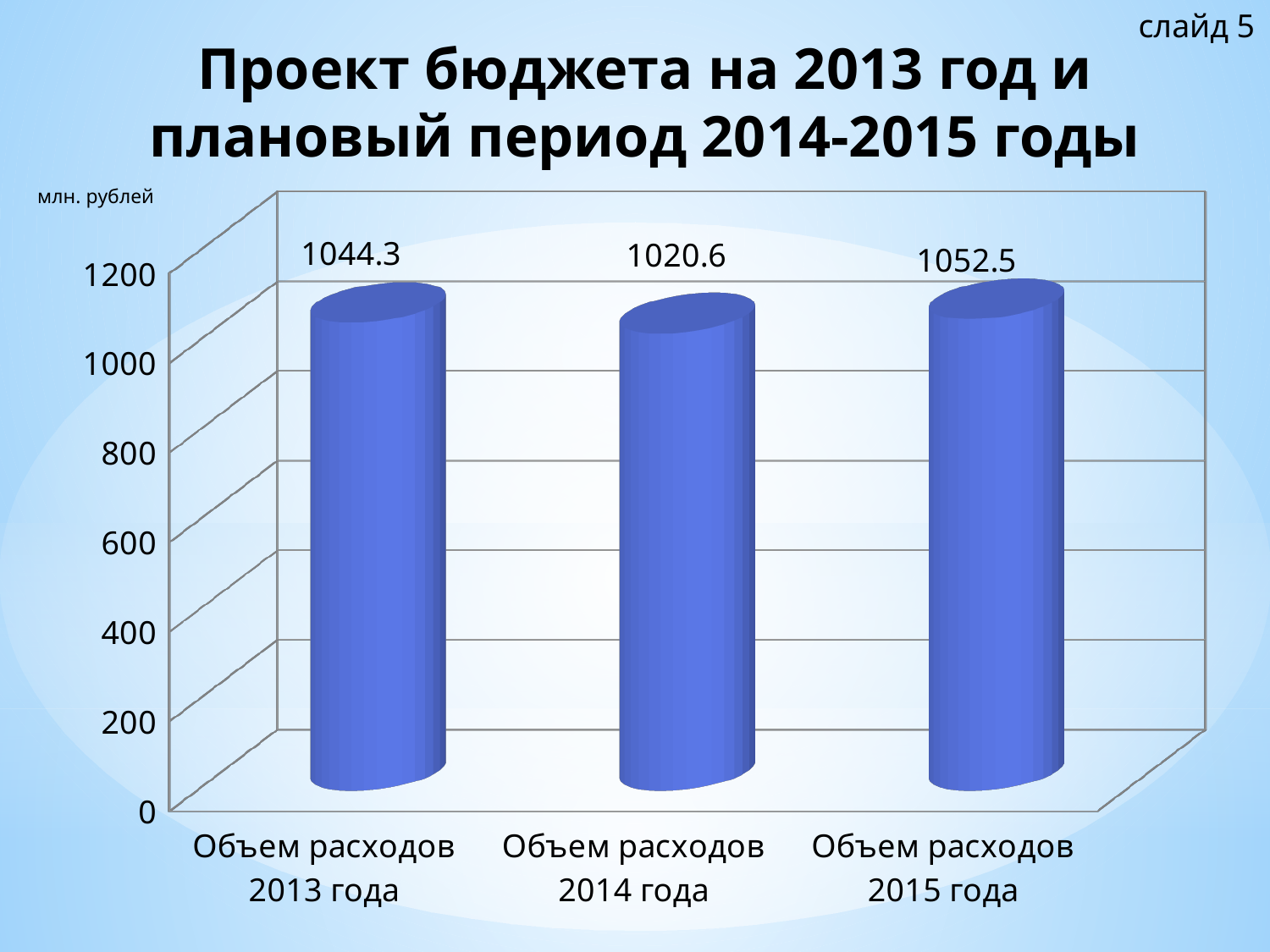
Which category has the lowest value? Объем расходов 2014 года Which category has the highest value? Объем расходов 2015 года What is the value for Объем расходов 2014 года? 1020.6 Is the value for Объем расходов 2014 года greater or less than 1000? greater Which is larger, the value for Объем расходов 2013 года or Объем расходов 2015 года? Объем расходов 2015 года What unit is indicated above the vertical axis of the chart? млн. рублей What is the value for Объем расходов 2015 года? 1052.5 What is the value for Объем расходов 2013 года? 1044.3 What is the difference between the values for Объем расходов 2015 года and Объем расходов 2014 года? 31.9 What kind of chart is shown on the slide? bar chart How many categories are shown in the chart? 3 What is the difference between the values for Объем расходов 2013 года and Объем расходов 2014 года? 23.7